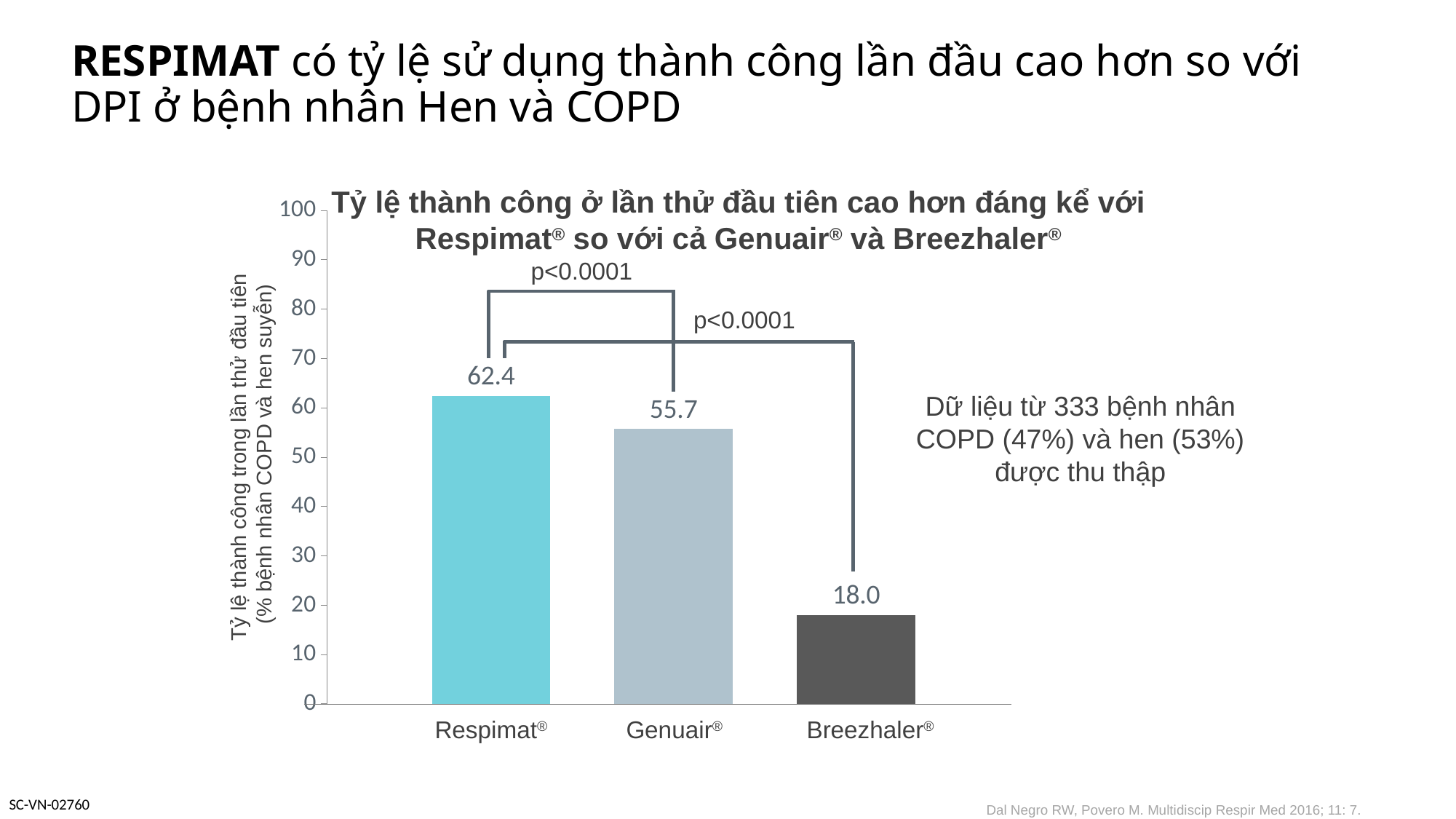
What is the first-attempt success rate shown for Breezhaler? 18.0 What type of chart is shown on the slide? Bar chart What is the first-attempt success rate shown for Respimat? 62.4 What is the difference between the success rates of Genuair and Breezhaler? 37.7 What is the difference between the success rates of Respimat and Genuair? 6.7 Which has a higher success rate, Genuair or Breezhaler? Genuair What p-value is shown for the comparison between Respimat and Genuair? p<0.0001 What is the first-attempt success rate shown for Genuair? 55.7 Which inhaler has the highest first-attempt success rate? Respimat Which inhaler has the lowest first-attempt success rate? Breezhaler How many inhalers are compared in the chart? 3 Is the value for Breezhaler greater or less than 20? less